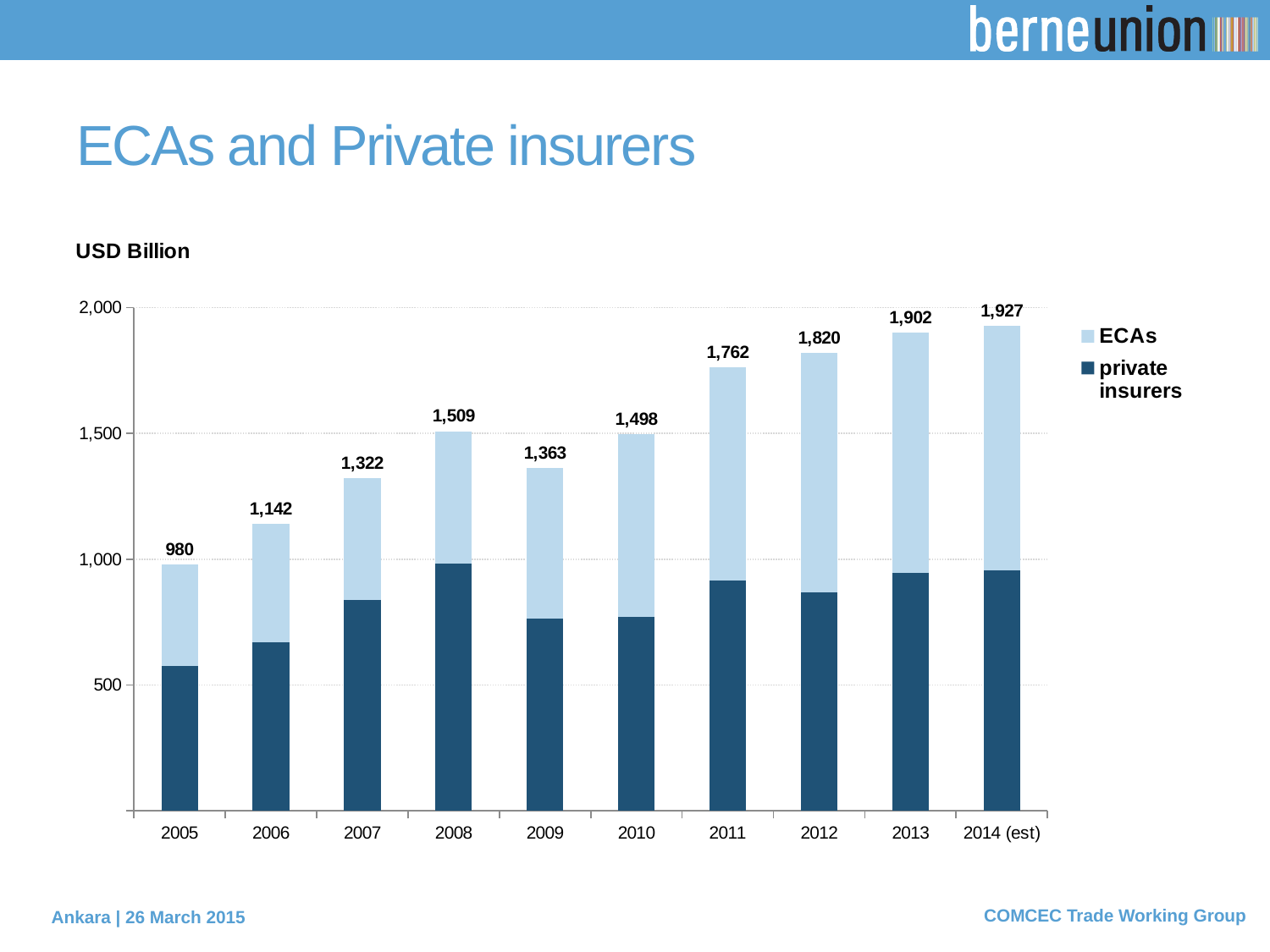
Did the total value rise or fall from 2008 to 2009? Fall What kind of chart is shown on the slide? Stacked bar chart How many years are shown on the x axis? 10 Is the value of the private insurers segment for 2005 greater or less than 1,000? less How many series does the legend list? 2 What is the difference between the total for 2013 and the total for 2012? 82 What is the total value shown for 2014 (est)? 1,927 Which year has the highest total value? 2014 (est) Which total is larger, 2008 or 2010? 2008 What is the total value shown for 2005? 980 Which year has the lowest total value? 2005 What is the total value shown for 2011? 1,762